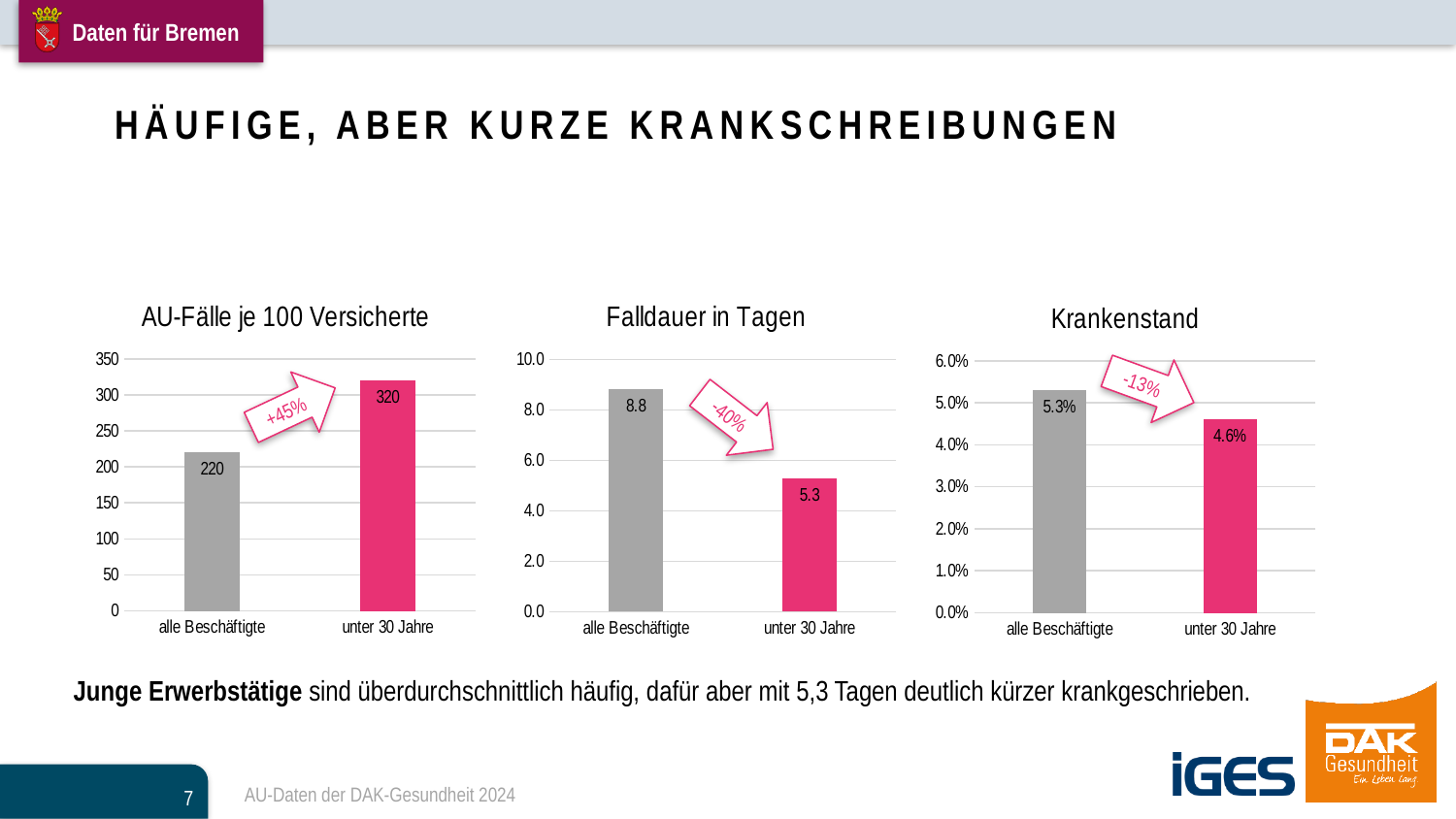
How many categories are shown in the chart titled "Krankenstand"? 2 In the chart titled "AU-Fälle je 100 Versicherte", what is the difference between the values for "unter 30 Jahre" and "alle Beschäftigte"? 100 In the chart titled "AU-Fälle je 100 Versicherte", what is the value for "unter 30 Jahre"? 320 In the chart titled "Krankenstand", what is the value for "unter 30 Jahre"? 4.6% In the chart titled "Krankenstand", what is the value for "alle Beschäftigte"? 5.3% In the chart titled "AU-Fälle je 100 Versicherte", what is the value for "alle Beschäftigte"? 220 In the chart titled "Falldauer in Tagen", which category has the higher value? alle Beschäftigte In the chart titled "Krankenstand", which category has the lower value? unter 30 Jahre In the chart titled "Falldauer in Tagen", what is the value for "unter 30 Jahre"? 5.3 In the chart titled "Falldauer in Tagen", what is the value for "alle Beschäftigte"? 8.8 What type of chart is the chart titled "AU-Fälle je 100 Versicherte"? bar chart In the chart titled "Falldauer in Tagen", what is the difference between the values for "alle Beschäftigte" and "unter 30 Jahre"? 3.5